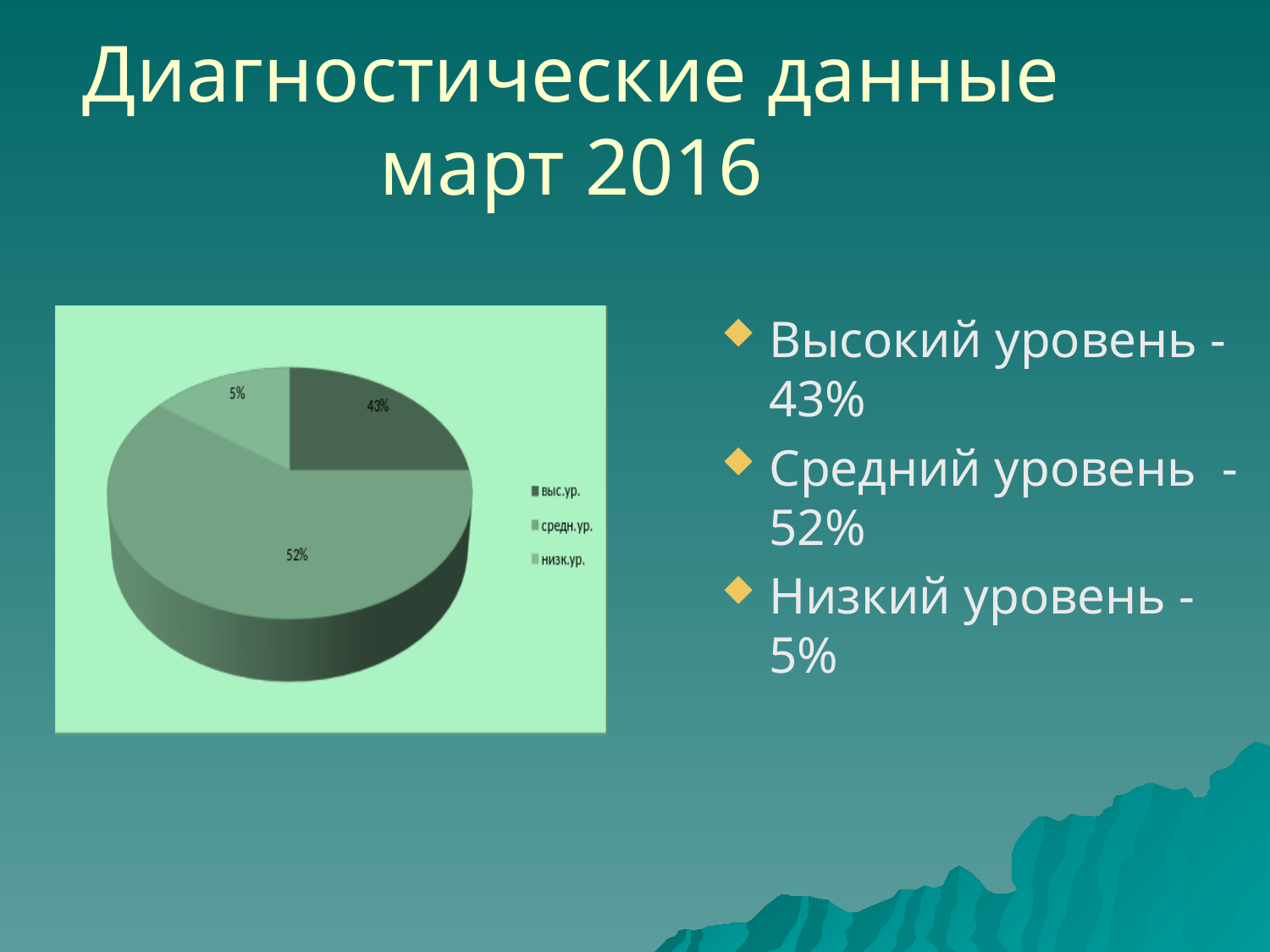
What share of the pie does the "средн.ур." slice represent? 52% Which slice of the pie is the largest? средн.ур. How many entries does the legend list? 3 What share of the pie does the "низк.ур." slice represent? 5% What is the difference in percentage points between the "средн.ур." slice and the "выс.ур." slice? 9 Which legend entry is listed first in the pie chart's legend? выс.ур. What share of the pie does the "выс.ур." slice represent? 43% What kind of chart is shown on the slide? pie chart Which is larger, the "выс.ур." slice or the "низк.ур." slice? выс.ур. What is the difference in percentage points between the "выс.ур." slice and the "низк.ур." slice? 38 Which slice of the pie is the smallest? низк.ур. How many slices does the pie chart have? 3